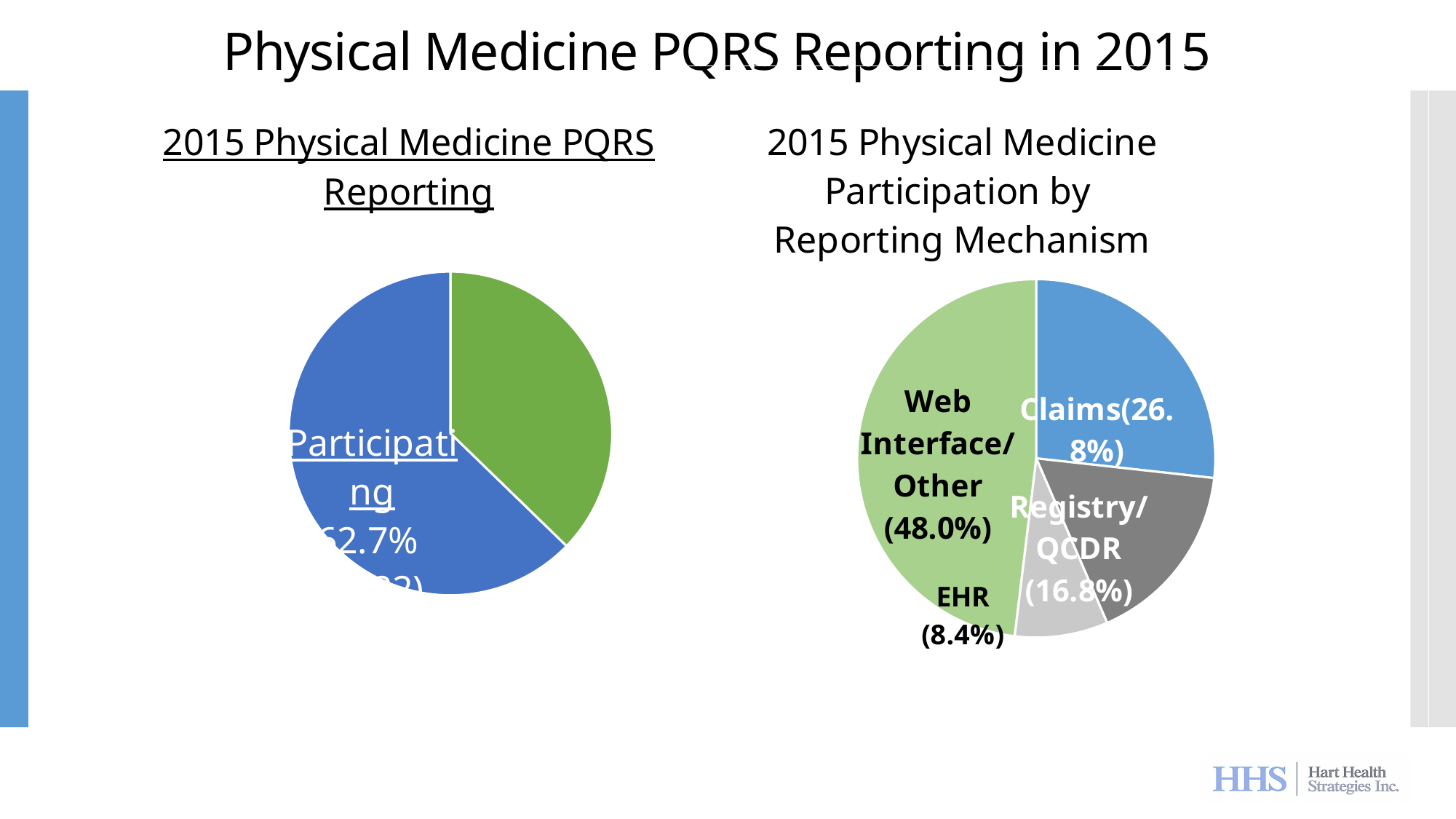
What kind of chart is the '2015 Physical Medicine PQRS Reporting' chart on the left? Pie chart How many slices does the '2015 Physical Medicine Participation by Reporting Mechanism' chart have? 4 In the '2015 Physical Medicine Participation by Reporting Mechanism' chart, what share is reported for Claims? 26.8% In the '2015 Physical Medicine Participation by Reporting Mechanism' chart, which reporting mechanism has the largest share? Web Interface/Other In the '2015 Physical Medicine Participation by Reporting Mechanism' chart, what share is reported for Web Interface/Other? 48.0% What kind of chart is the '2015 Physical Medicine Participation by Reporting Mechanism' chart? Pie chart In the '2015 Physical Medicine Participation by Reporting Mechanism' chart, which is larger: Claims or Registry/QCDR? Claims In the '2015 Physical Medicine Participation by Reporting Mechanism' chart, which reporting mechanism has the smallest share? EHR In the '2015 Physical Medicine Participation by Reporting Mechanism' chart, how many percentage points larger is the Claims share than the Registry/QCDR share? 10.0 percentage points In the '2015 Physical Medicine Participation by Reporting Mechanism' chart, what share is reported for Registry/QCDR? 16.8% In the '2015 Physical Medicine Participation by Reporting Mechanism' chart, what share is reported for EHR? 8.4% In the '2015 Physical Medicine PQRS Reporting' chart on the left, which slice is larger: the blue 'Participating' slice or the green slice? The blue 'Participating' slice